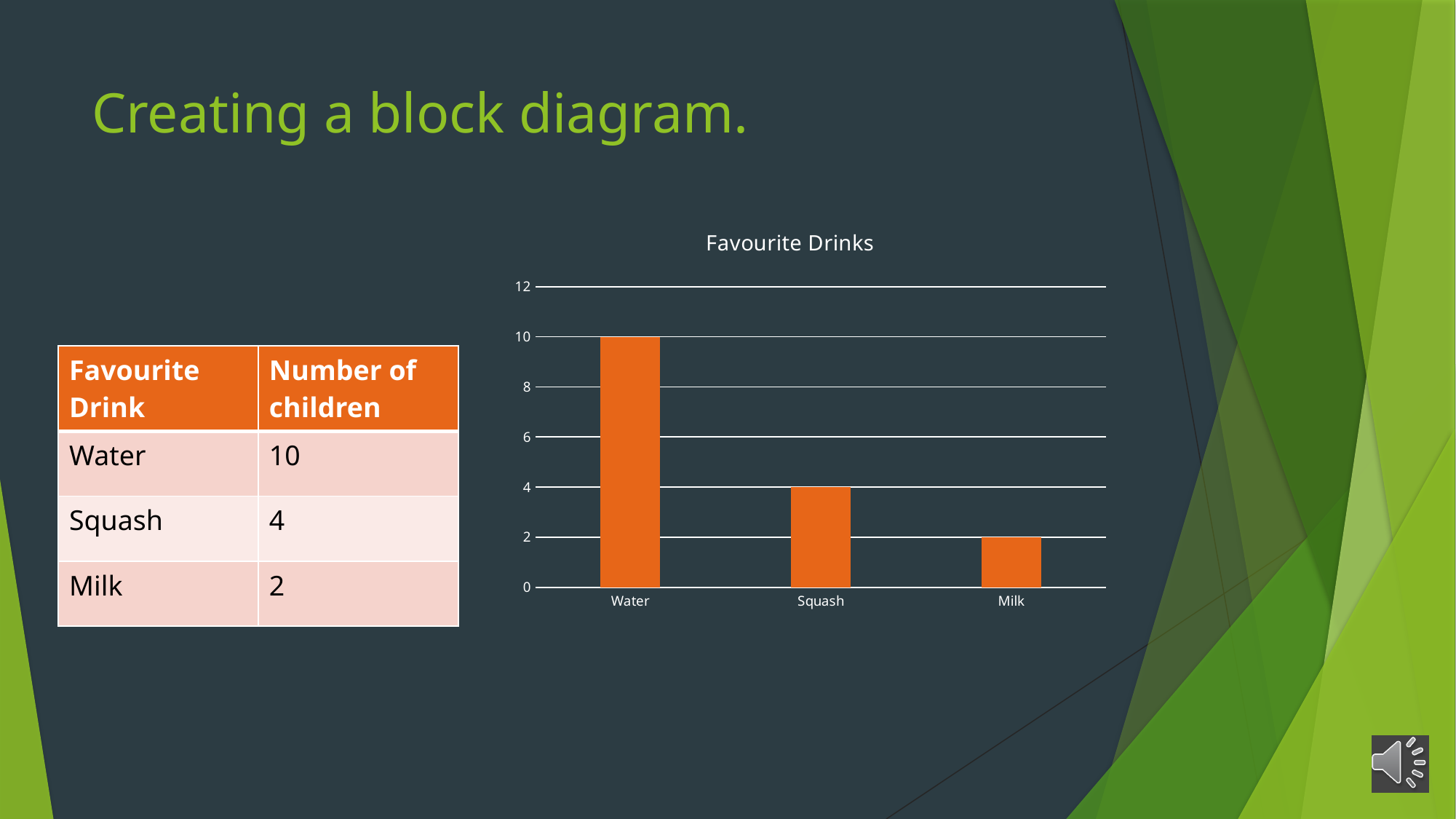
Is the value for Water in the Favourite Drinks chart greater or less than 8? greater What is the value for Squash in the Favourite Drinks chart? 4 How many drink categories are shown in the Favourite Drinks chart? 3 Which drink has the lowest value in the Favourite Drinks chart? Milk What kind of chart is the Favourite Drinks chart? bar chart What is the title of the chart on the slide? Favourite Drinks What is the difference between the values for Water and Squash in the Favourite Drinks chart? 6 What is the value for Milk in the Favourite Drinks chart? 2 Which drink has the highest value in the Favourite Drinks chart? Water What is the difference between the values for Squash and Milk in the Favourite Drinks chart? 2 Which is larger in the Favourite Drinks chart, the value for Squash or the value for Milk? Squash What is the value for Water in the Favourite Drinks chart? 10